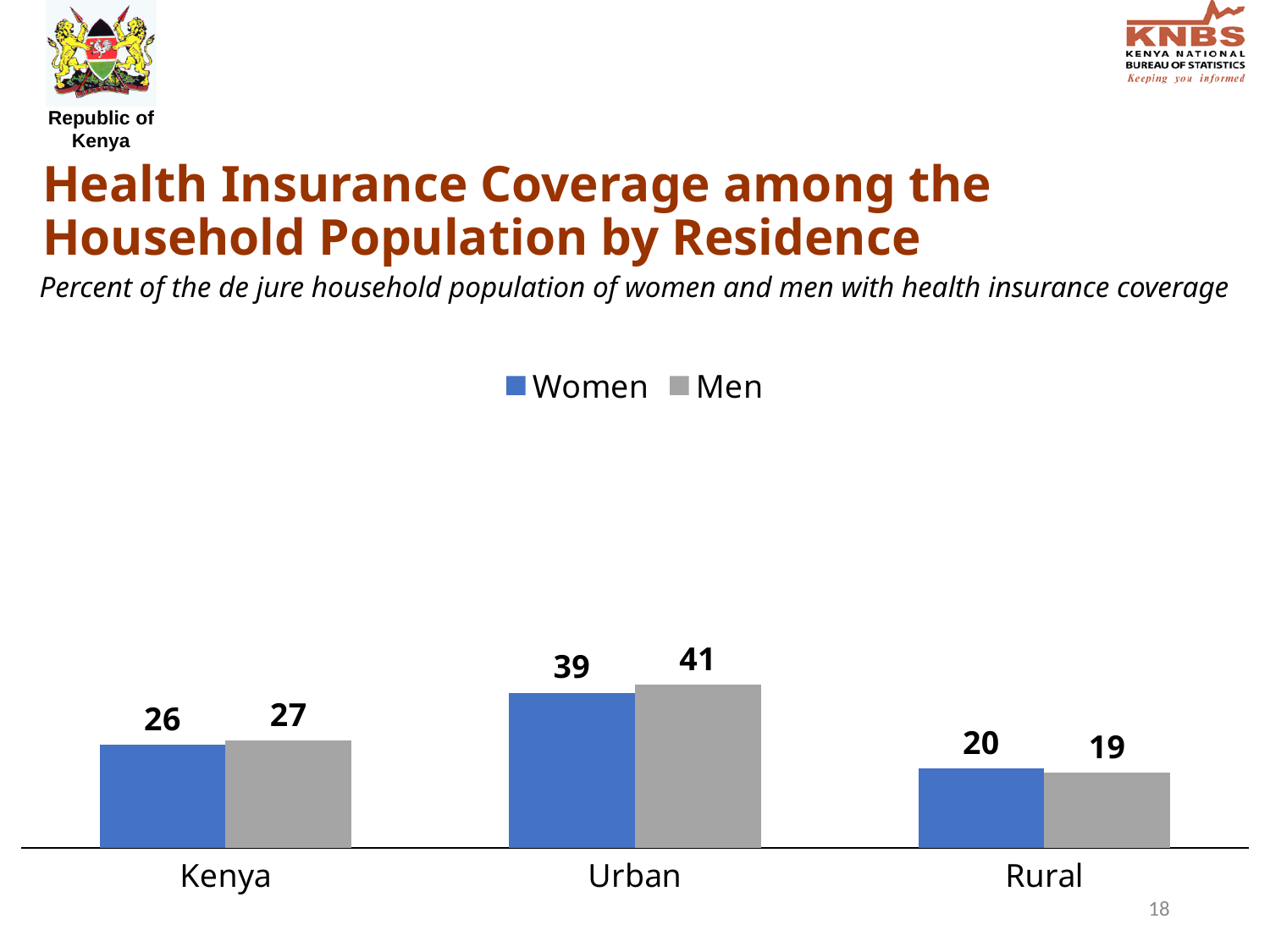
Which is larger, the Women value for Kenya or the Women value for Rural? Kenya What is the difference between the Women values for Urban and Rural? 19 What is the value for Men in Rural? 19 How many series does the legend list? 2 What kind of chart is shown on the slide? Bar chart What is the difference between the Men and Women values in Urban? 2 What is the value for Men in Kenya? 27 How many residence categories are shown on the x axis? 3 What is the value for Women in Rural? 20 Which residence category has the highest value for Men? Urban What is the value for Women in Urban? 39 Which residence category has the lowest value for Women? Rural